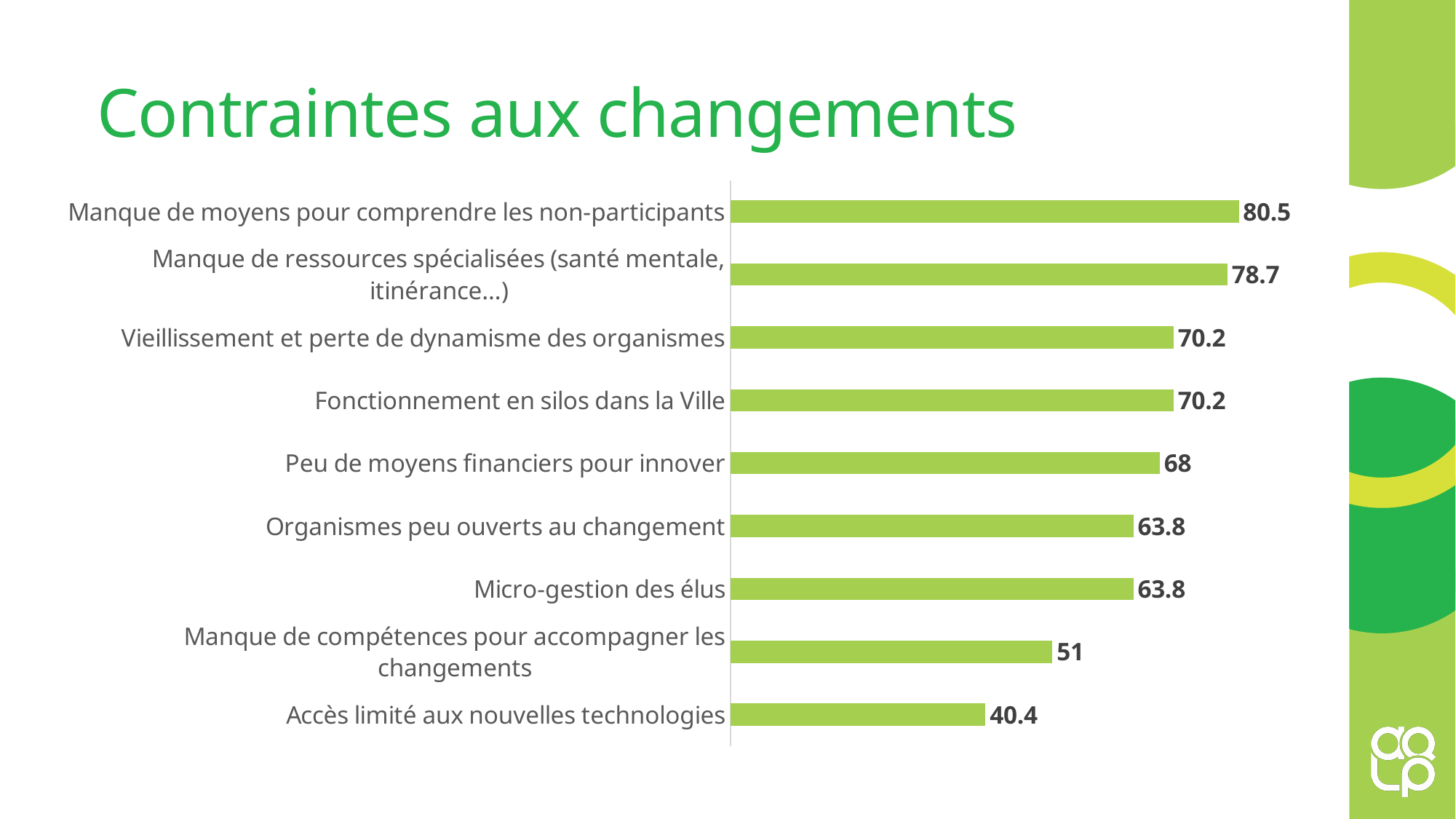
Which is larger: the value for "Vieillissement et perte de dynamisme des organismes" or the value for "Micro-gestion des élus"? Vieillissement et perte de dynamisme des organismes Which category has the lowest value? Accès limité aux nouvelles technologies What is the value for "Manque de compétences pour accompagner les changements"? 51 Which category has the highest value? Manque de moyens pour comprendre les non-participants What is the value for "Accès limité aux nouvelles technologies"? 40.4 What is the title of the slide? Contraintes aux changements What is the value for "Peu de moyens financiers pour innover"? 68 What is the difference between the values for "Peu de moyens financiers pour innover" and "Manque de compétences pour accompagner les changements"? 17 What kind of chart is shown on the slide? Bar chart What is the value for "Manque de moyens pour comprendre les non-participants"? 80.5 How many categories are shown in the chart? 9 What is the difference between the values for "Manque de moyens pour comprendre les non-participants" and "Accès limité aux nouvelles technologies"? 40.1